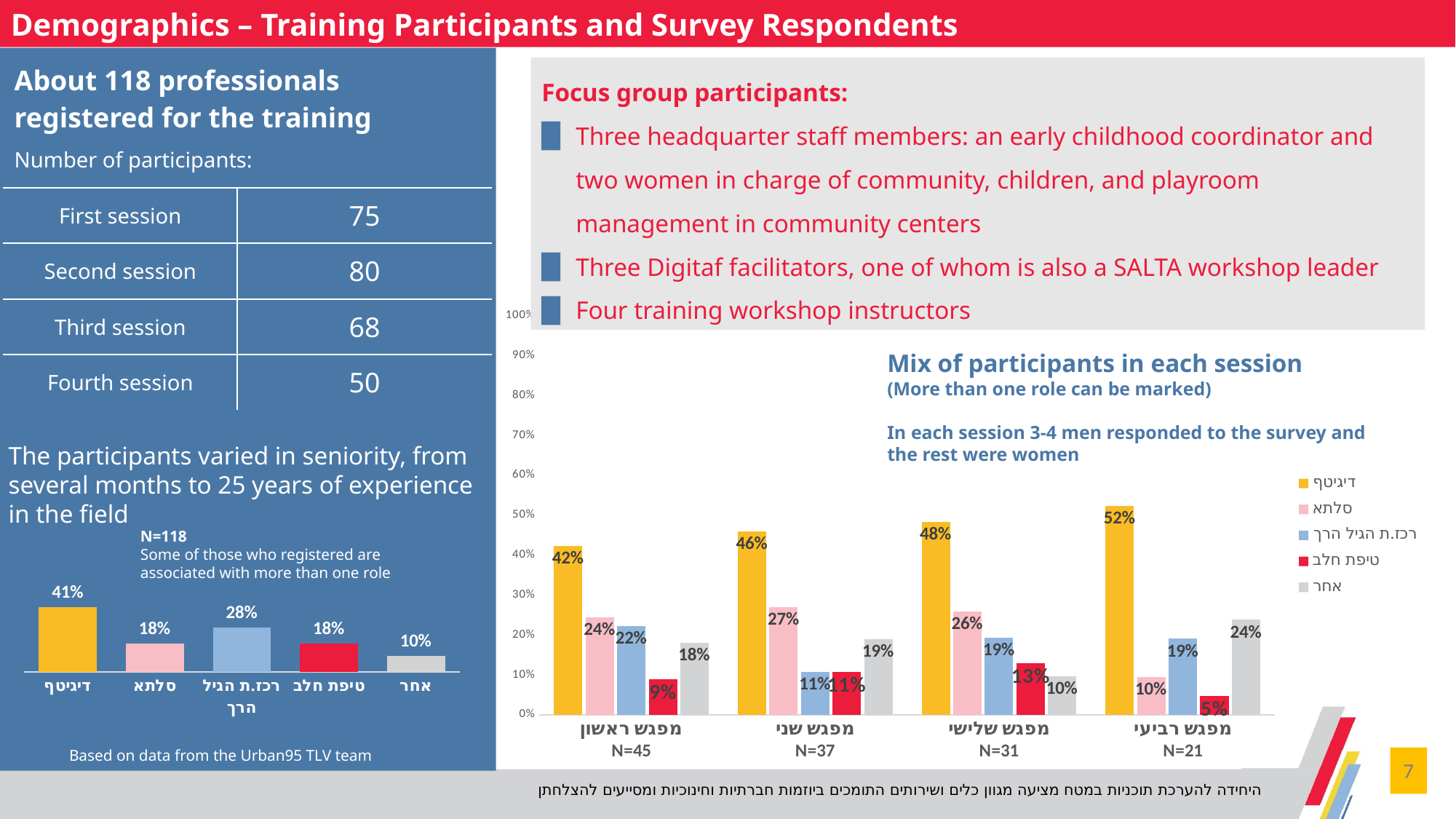
In the 'Mix of participants in each session' chart, what is the value for טיפת חלב in מפגש ראשון? 9% In the 'Mix of participants in each session' chart, which is larger in מפגש שני: סלתא or אחר? סלתא In the 'Mix of participants in each session' chart, how many series does the legend list? 5 In the 'Mix of participants in each session' chart, what is the difference between the דיגיטף values for מפגש רביעי and מפגש ראשון? 10% In the 'Mix of participants in each session' chart, which session has the highest value for דיגיטף? מפגש רביעי In the small bar chart on the left (N=118), what is the value for רכז.ת הגיל הרך? 28% In the 'Mix of participants in each session' chart, do the דיגיטף values rise or fall from מפגש ראשון to מפגש רביעי? rise In the 'Mix of participants in each session' chart, which session has the lowest value for טיפת חלב? מפגש רביעי In the 'Mix of participants in each session' chart, what is the value for דיגיטף in מפגש רביעי? 52% In the 'Mix of participants in each session' chart, how many sessions are shown on the x axis? 4 What kind of chart is the 'Mix of participants in each session' chart? bar chart In the small bar chart on the left (N=118), which category has the highest value? דיגיטף